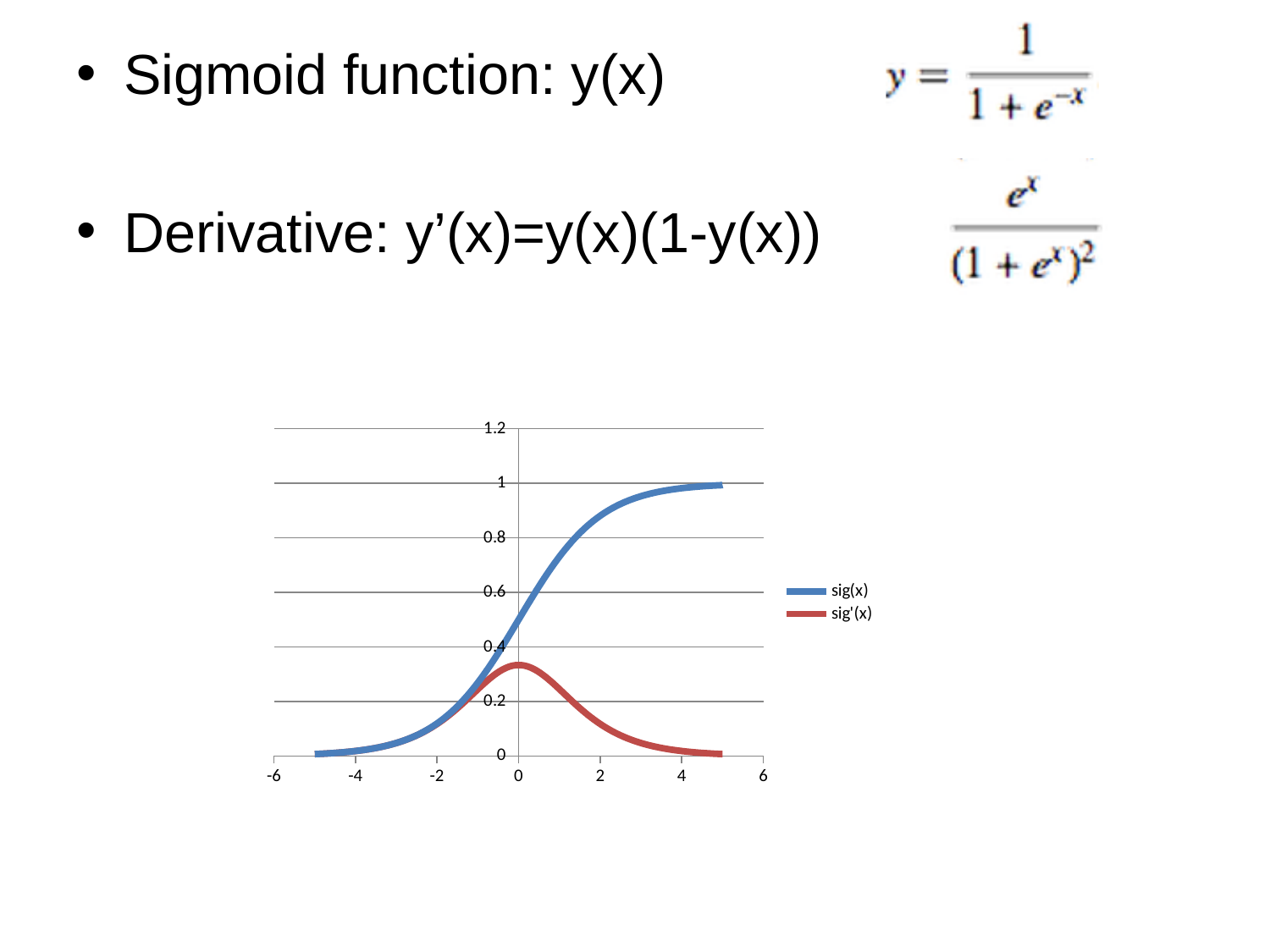
What is the highest value labelled on the chart's vertical axis? 1.2 Which colour is used for the sig'(x) series in the chart? red Is the value of sig'(x) at x = 4 greater or less than 0.2? less Is the value of sig'(x) at x = 0 greater or less than 0.2? greater What kind of chart is shown on the slide? line chart Is the value of sig(x) at x = 4 greater or less than 0.8? greater How many series does the chart's legend list? 2 What are the two series named in the chart's legend? sig(x) and sig'(x) At which x value does the sig'(x) curve reach its highest point? 0 At x = 2, which series has the larger value, sig(x) or sig'(x)? sig(x) Does the sig(x) curve rise or fall as x increases from -6 to 6? rise